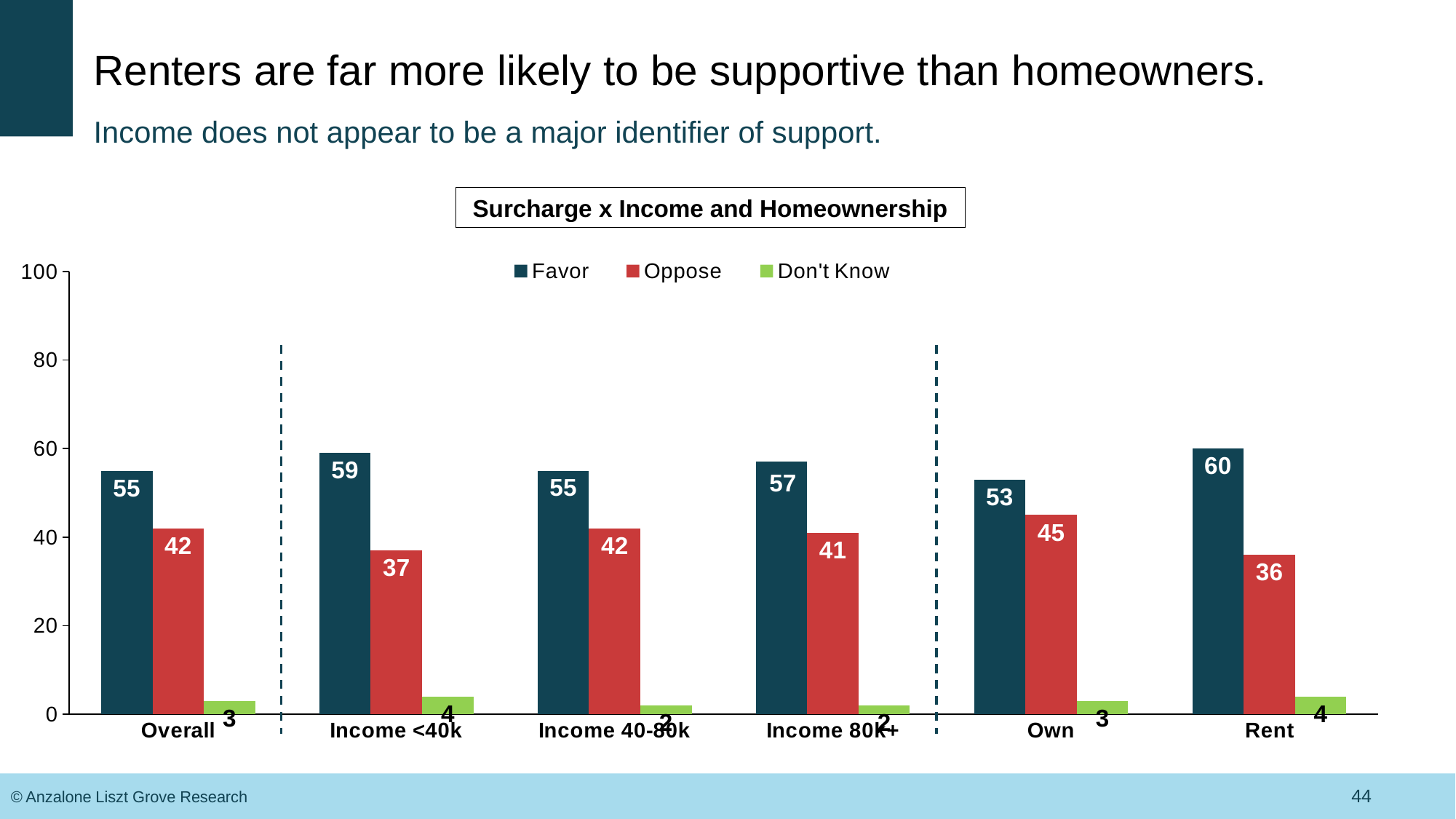
How many categories are shown on the x axis? 6 Which category has the lowest Oppose value? Rent What is the title of the chart? Surcharge x Income and Homeownership What is the Don't Know value for Overall? 3 What is the difference between the Favor values for Rent and Own? 7 What kind of chart is shown? Bar chart Is the Oppose value larger for Own or for Rent? Own Which category has the highest Favor value? Rent What is the Favor value for Income <40k? 59 What is the Oppose value for Own? 45 How many series does the legend list? 3 What is the Favor value for Rent? 60